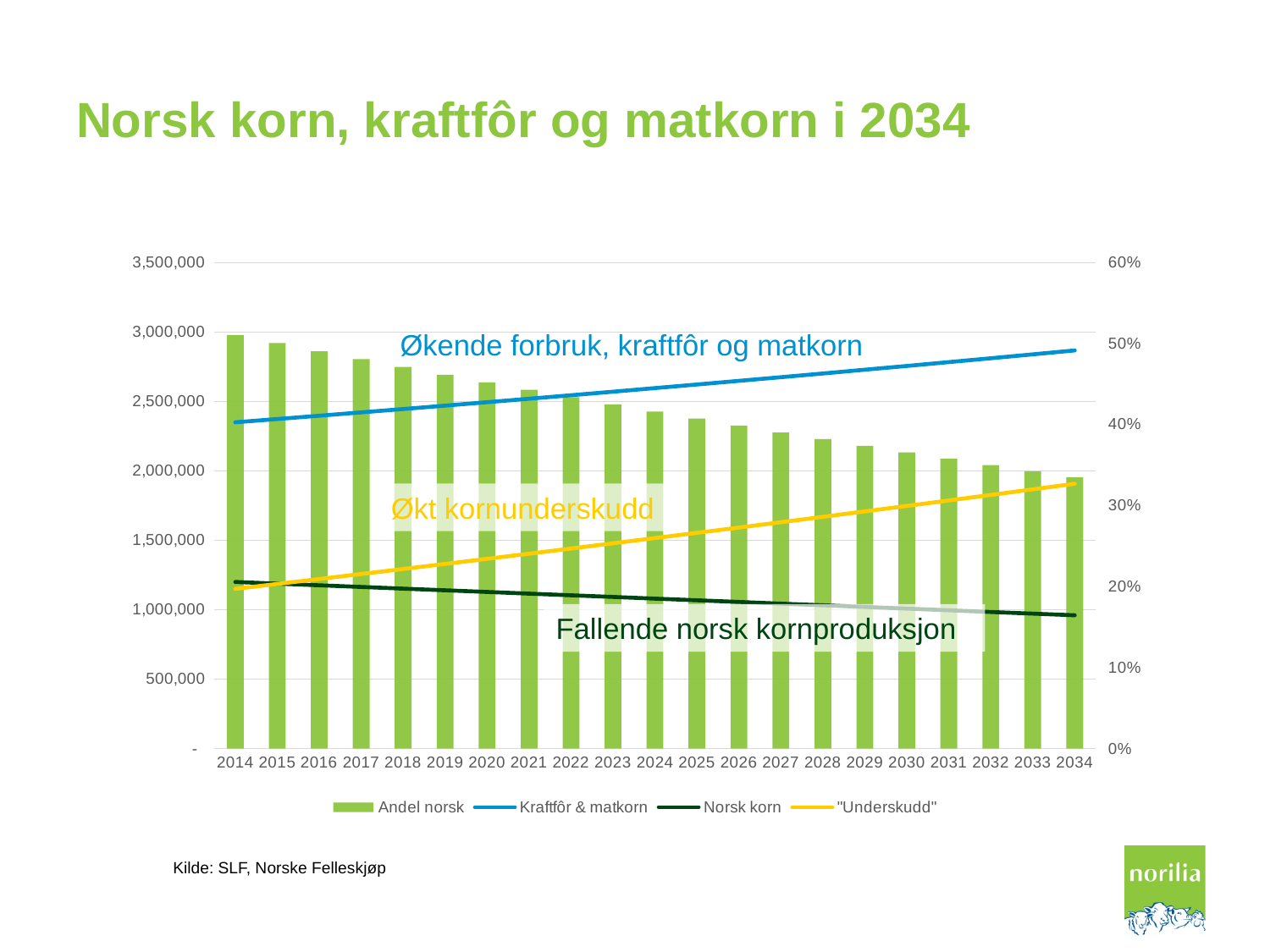
In 2034, which line is higher: "Underskudd" or Norsk korn? "Underskudd" Which year has the lowest bar for Andel norsk? 2034 How many series does the chart legend list? 4 Do the Andel norsk bars rise or fall from 2014 to 2034? Fall Is the value of the Norsk korn line in 2034 greater or less than 1,000,000? less How many years are shown along the x axis of the chart? 21 Is the value of the Kraftfôr & matkorn line in 2034 greater or less than 2,500,000? greater What is the title of the slide containing the chart? Norsk korn, kraftfôr og matkorn i 2034 Which year has the highest bar for Andel norsk? 2014 Is the Andel norsk bar for 2034 greater or less than 40%? less Does the Kraftfôr & matkorn line rise or fall from 2014 to 2034? Rise What kind of chart is shown on the slide? A combined bar and line chart